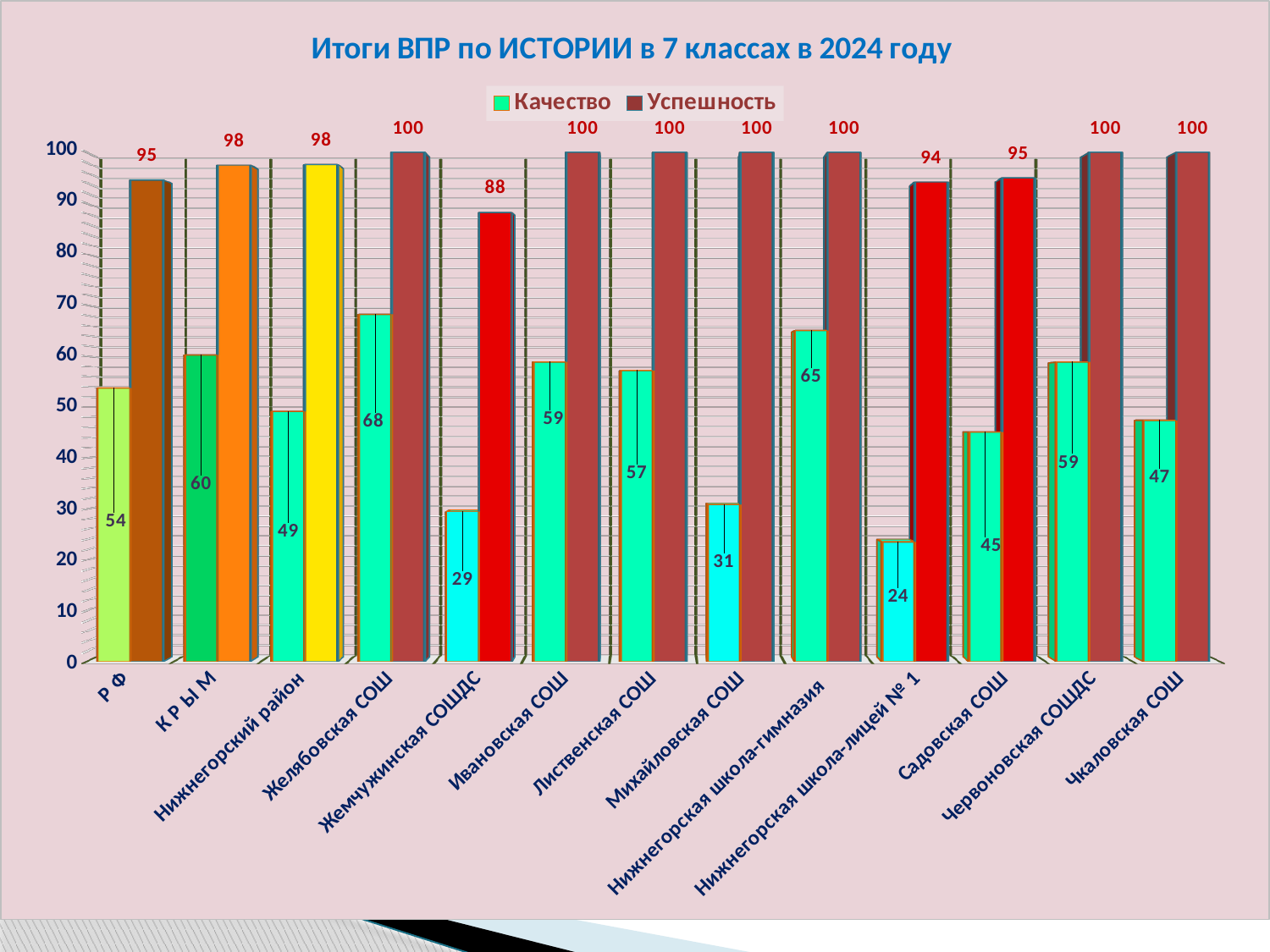
What is the difference between the Успешность and Качество values for Р Ф? 41 What is the Качество value for Нижнегорская школа-гимназия? 65 What is the Качество value for Желябовская СОШ? 68 Which category has the lowest Качество value? Нижнегорская школа-лицей № 1 Which category has the lowest Успешность value? Жемчужинская СОШДС What is the Успешность value for Жемчужинская СОШДС? 88 How many categories are shown on the x axis? 13 What kind of chart is shown on the slide? Bar chart How many series does the legend list? 2 Which is larger: the Качество value for К Р Ы М or for Садовская СОШ? К Р Ы М What is the title of the chart? Итоги ВПР по ИСТОРИИ в 7 классах в 2024 году Which category has the highest Качество value? Желябовская СОШ